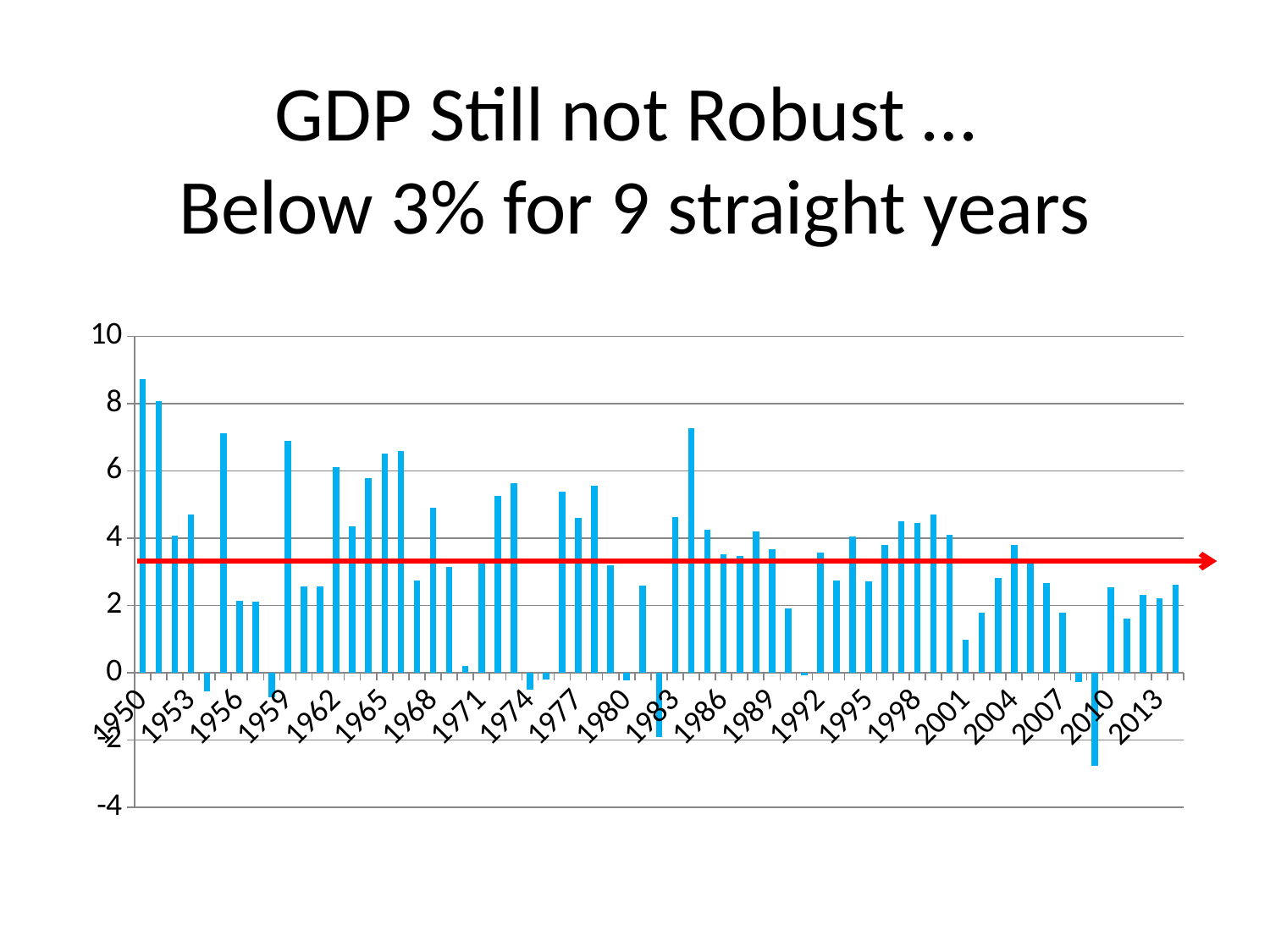
Is the value for 1956 greater or less than 4? less Is the value for 1959 greater or less than 6? greater What colour is the horizontal arrow drawn across the chart? red Is the value for 2013 greater or less than 4? less Which is larger, the value for 1950 or the value for 1953? 1950 What is the title of the slide above the chart? GDP Still not Robust … Below 3% for 9 straight years Overall, do the bar values tend to rise or fall from 1950 to 2013? fall Which year has the tallest bar in the chart? 1950 What kind of chart is shown on the slide? bar chart